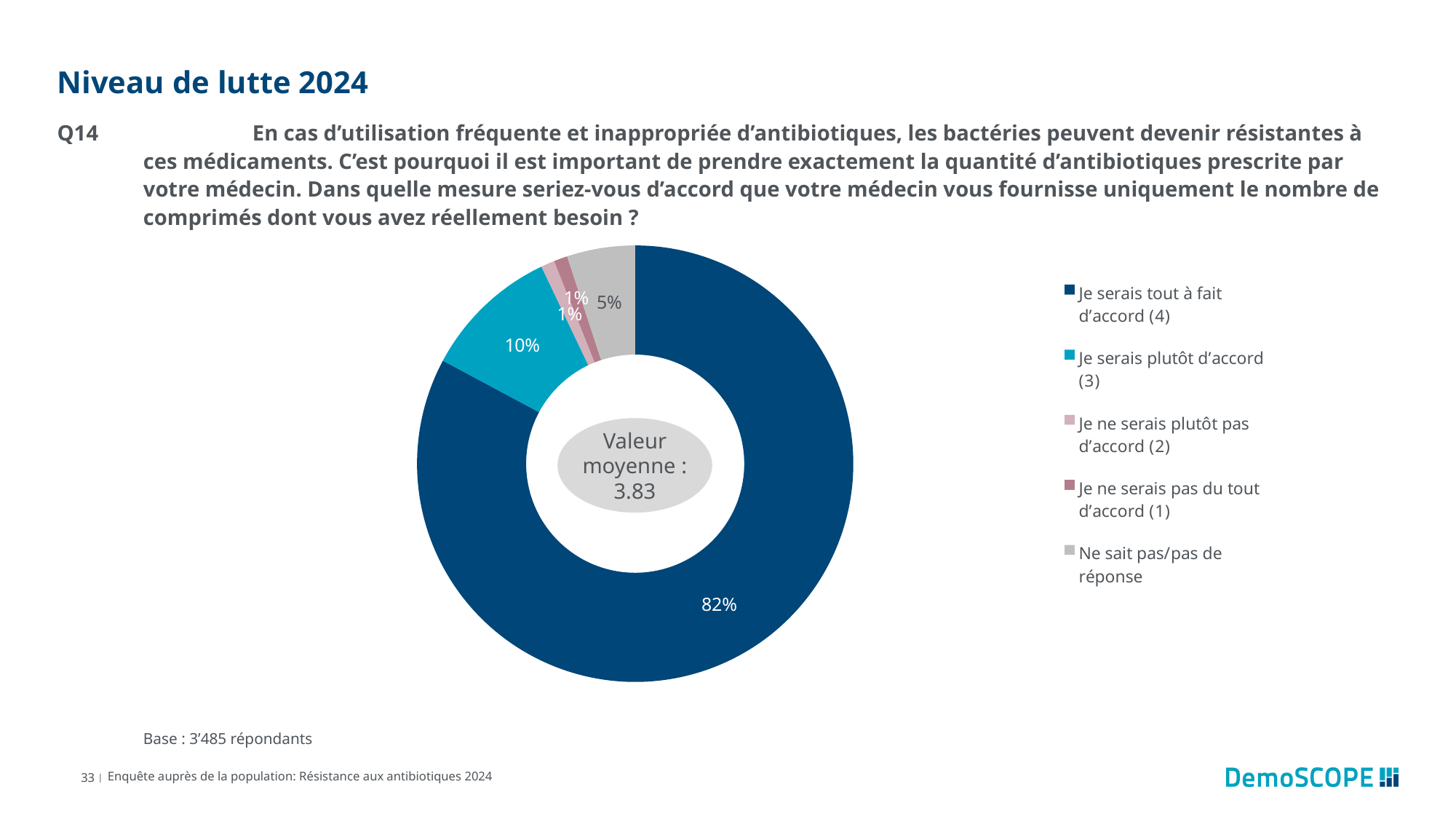
Which is larger: the share for "Je serais plutôt d'accord (3)" or the share for "Ne sait pas/pas de réponse"? Je serais plutôt d'accord (3) How many respondents form the base of this chart? 3'485 What kind of chart is shown on the slide? Pie chart (doughnut) What share of respondents answered "Je serais plutôt d'accord (3)"? 10% What share of respondents answered "Je serais tout à fait d'accord (4)"? 82% What is the difference in percentage points between "Je serais tout à fait d'accord (4)" and "Je serais plutôt d'accord (3)"? 72 What is the combined share of "Je serais tout à fait d'accord (4)" and "Je serais plutôt d'accord (3)"? 92% What share of respondents answered "Je ne serais pas du tout d'accord (1)"? 1% What is the mean value (Valeur moyenne) shown in the centre of the chart? 3.83 Which response category has the largest share of the pie? Je serais tout à fait d'accord (4) What share of respondents answered "Ne sait pas/pas de réponse"? 5% How many response categories does the legend list? 5